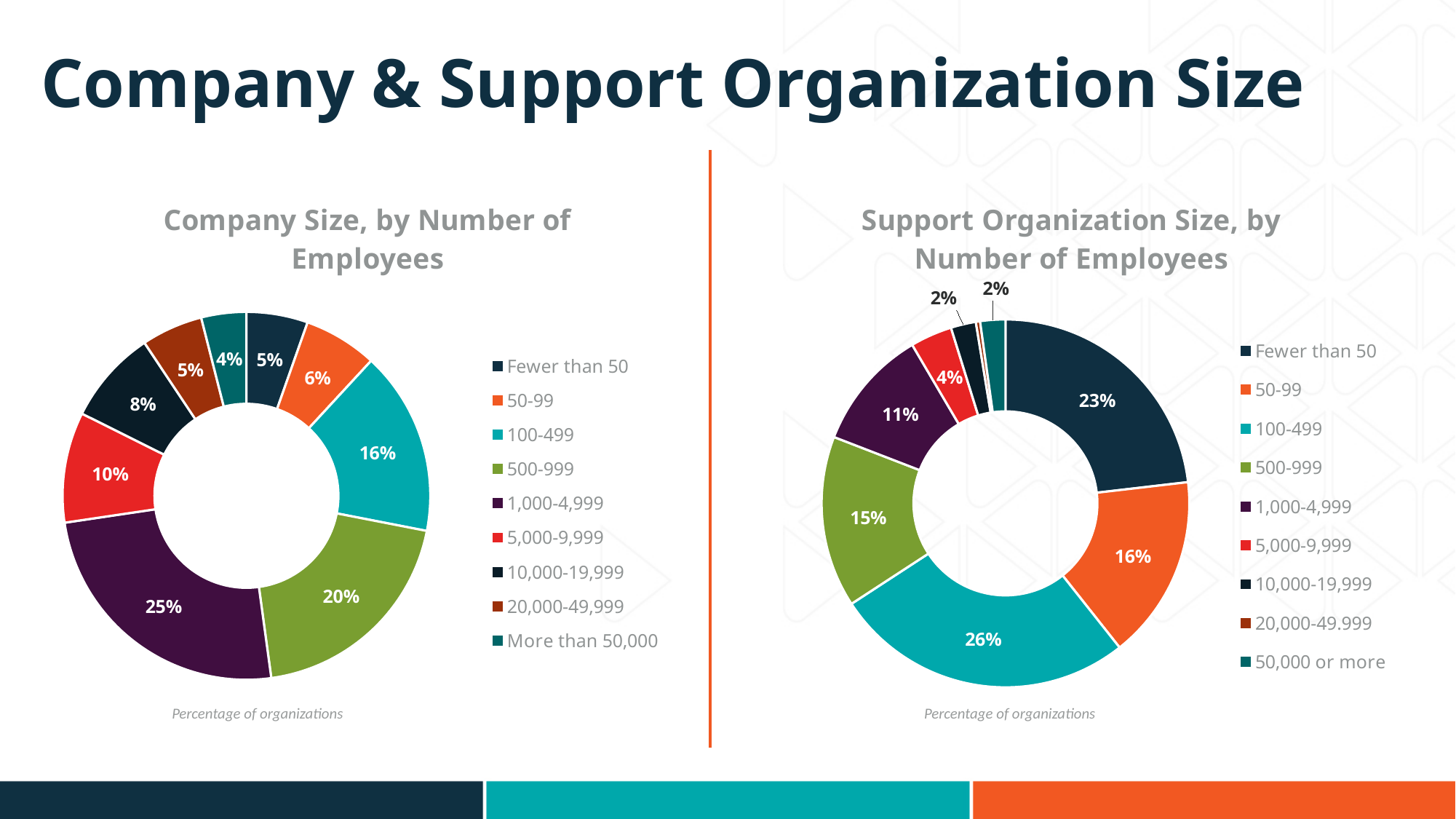
In the Company Size, by Number of Employees chart, what percentage of organizations have 100-499 employees? 16% In the Support Organization Size, by Number of Employees chart, which category has the largest share? 100-499 What type of chart is the Support Organization Size, by Number of Employees chart? Doughnut (pie) chart In the Support Organization Size, by Number of Employees chart, what is the difference between the 50-99 share and the 5,000-9,999 share? 12% In the Company Size, by Number of Employees chart, which category has the largest share? 1,000-4,999 In the Support Organization Size, by Number of Employees chart, what percentage of organizations have 100-499 employees? 26% In the Support Organization Size, by Number of Employees chart, which is larger: the share for 500-999 or the share for 1,000-4,999? 500-999 In the Company Size, by Number of Employees chart, what percentage of organizations have 1,000-4,999 employees? 25% In the Company Size, by Number of Employees chart, which category has the smallest share? More than 50,000 In the Company Size, by Number of Employees chart, what is the difference between the 500-999 share and the 5,000-9,999 share? 10% How many entries does the legend of the Company Size, by Number of Employees chart list? 9 In the Support Organization Size, by Number of Employees chart, what percentage of organizations have fewer than 50 employees? 23%